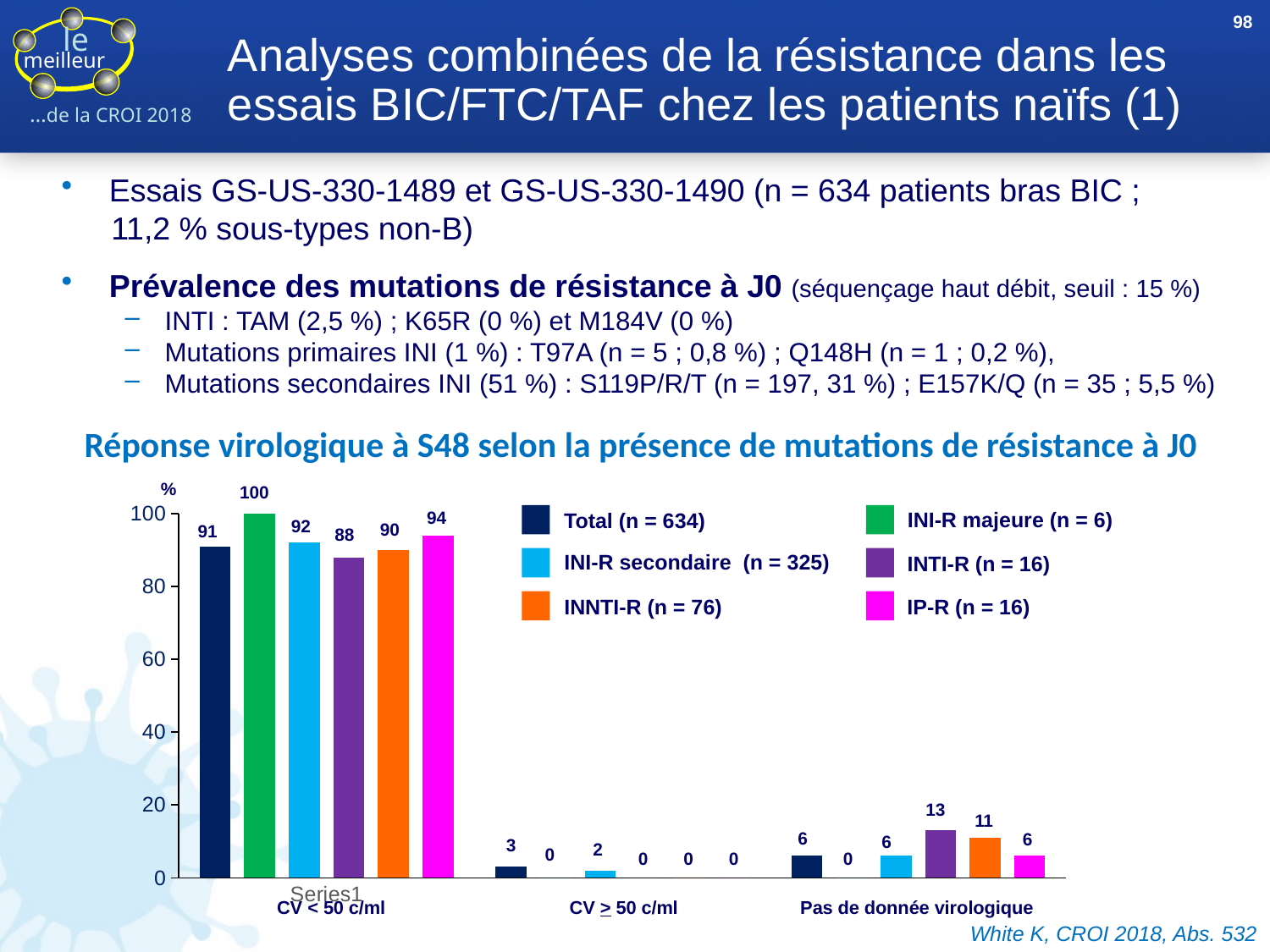
In the Pas de donnée virologique category, which is larger: INTI-R or INNTI-R? INTI-R Which series has the lowest value in the CV < 50 c/ml category? INTI-R Which series has the highest value in the CV < 50 c/ml category? INI-R majeure What is the difference between the IP-R and INTI-R values in the CV < 50 c/ml category? 6 How many categories are shown on the x axis of the chart? 3 What is the value for Total in the CV ≥ 50 c/ml category? 3 What is the value for INI-R majeure in the CV < 50 c/ml category? 100 What is the value for Total in the CV < 50 c/ml category? 91 What kind of chart is shown on the slide? Bar chart What is the value for INTI-R in the Pas de donnée virologique category? 13 What is the title of the chart? Réponse virologique à S48 selon la présence de mutations de résistance à J0 How many series does the chart legend list? 6